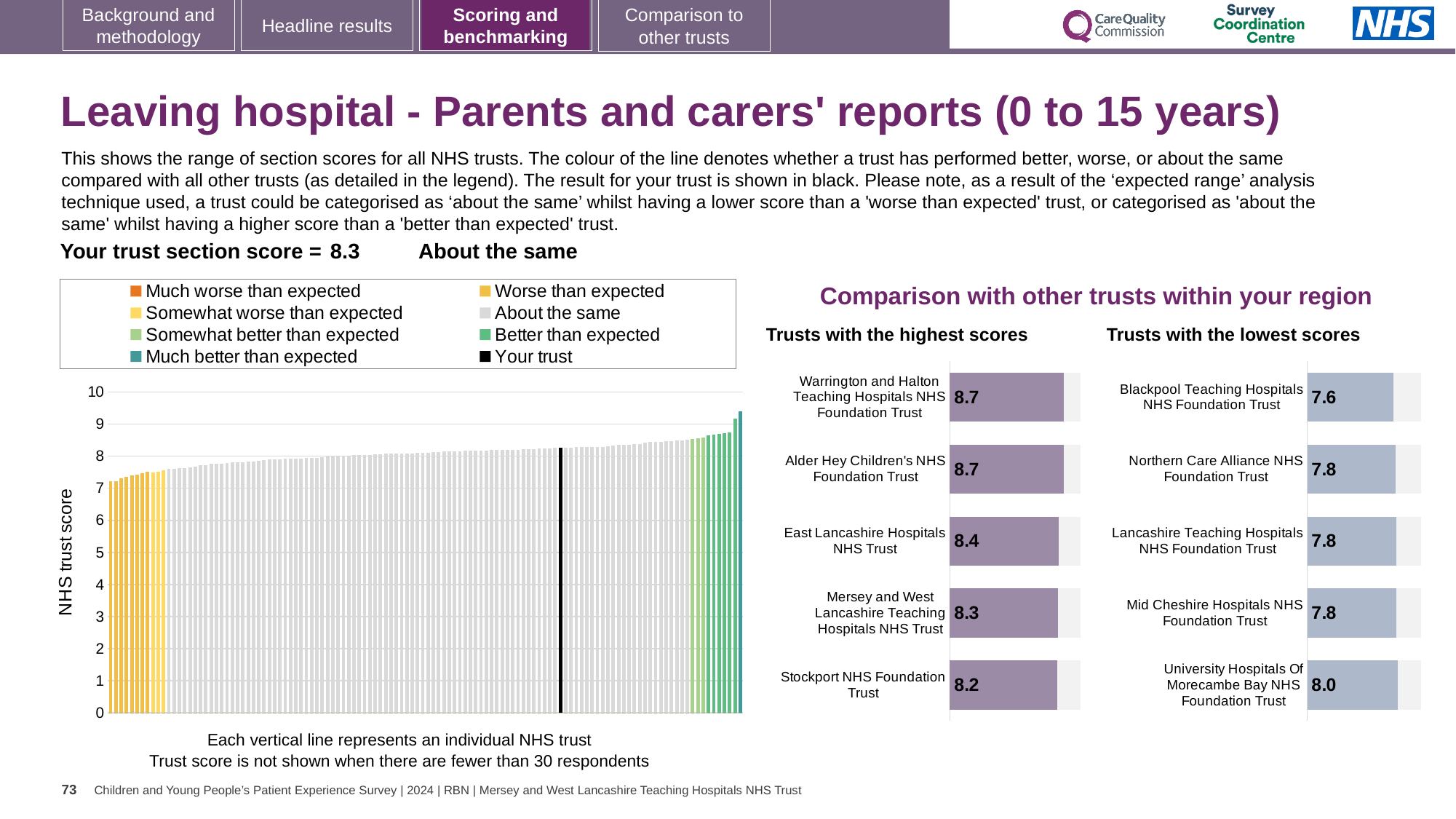
In the 'Trusts with the lowest scores' chart, what is the difference between the scores of University Hospitals Of Morecambe Bay NHS Foundation Trust and Blackpool Teaching Hospitals NHS Foundation Trust? 0.4 How many trusts are listed in the 'Trusts with the highest scores' chart? 5 In the 'Trusts with the highest scores' chart, what is the score for Stockport NHS Foundation Trust? 8.2 In the 'Trusts with the highest scores' chart, what is the score for Warrington and Halton Teaching Hospitals NHS Foundation Trust? 8.7 In the 'Trusts with the lowest scores' chart, which trust has the highest score? University Hospitals Of Morecambe Bay NHS Foundation Trust In the 'Trusts with the lowest scores' chart, which trust has the lowest score? Blackpool Teaching Hospitals NHS Foundation Trust How many entries does the legend of the main chart on the left list? 8 In the 'Trusts with the lowest scores' chart, what is the score for Blackpool Teaching Hospitals NHS Foundation Trust? 7.6 In the 'Trusts with the highest scores' chart, which has the larger score: East Lancashire Hospitals NHS Trust or Mersey and West Lancashire Teaching Hospitals NHS Trust? East Lancashire Hospitals NHS Trust In the main chart on the left showing the range of section scores, do the values rise or fall from left to right? rise In the 'Trusts with the highest scores' chart, what is the difference between the scores of Warrington and Halton Teaching Hospitals NHS Foundation Trust and Stockport NHS Foundation Trust? 0.5 In the main chart on the left showing the range of section scores, is the value for the highest-scoring trust greater or less than 9? greater